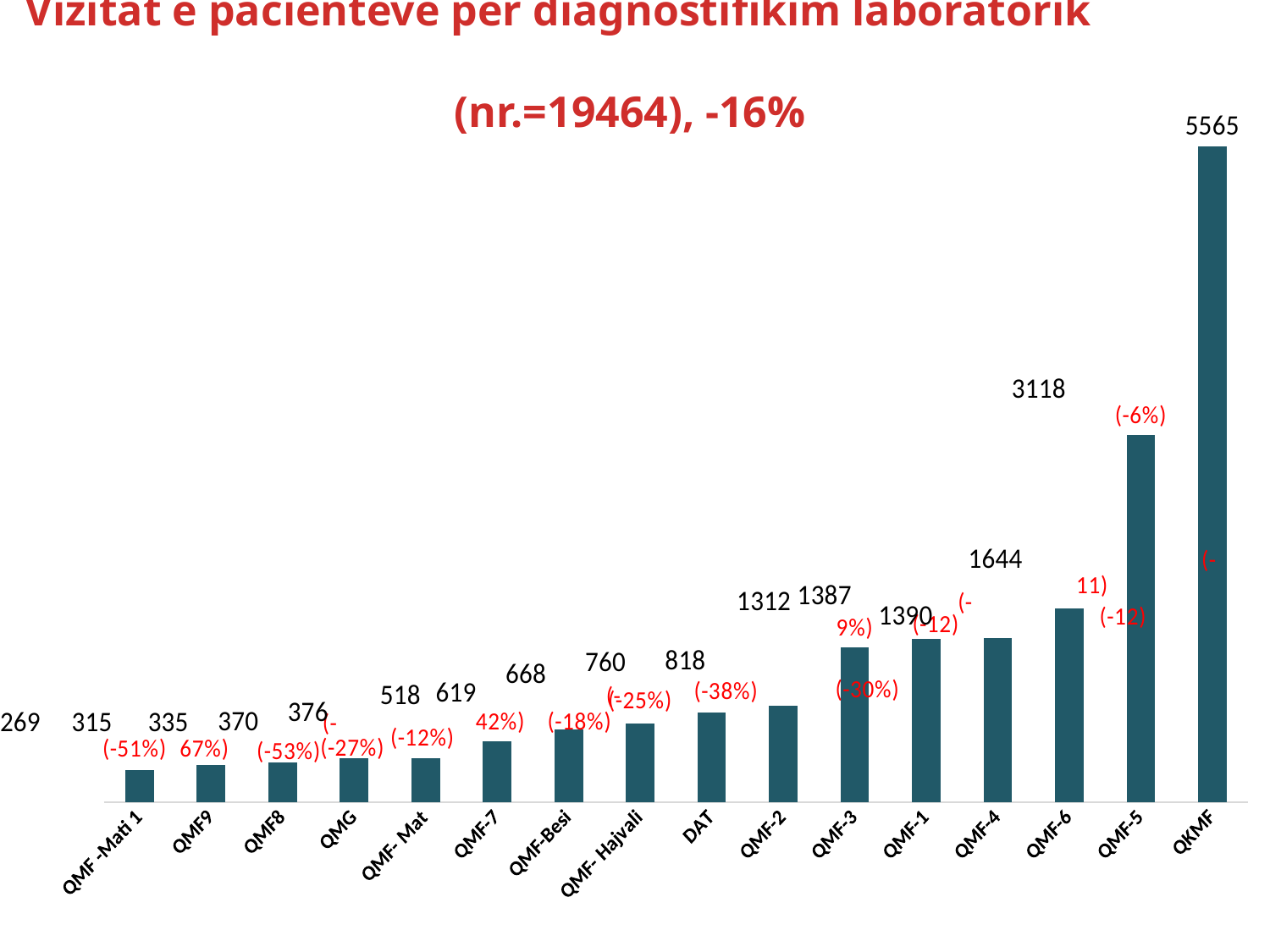
What is the value for QMF-5? 3118 What kind of chart is shown on the slide? bar chart What total number (nr.) is given in the chart title? 19464 What is the value for QKMF? 5565 What is the value for QMF-6? 1644 Do the bar values rise or fall from left to right along the x axis? rise What is the value for DAT? 760 Which category has the lowest number of visits? QMF -Mati 1 What is the difference between the values for QKMF and QMF-5? 2447 Which category has the highest number of visits? QKMF How many categories (bars) are shown in the chart? 16 Which is larger, the value for QMF-6 or the value for QMF-4? QMF-6